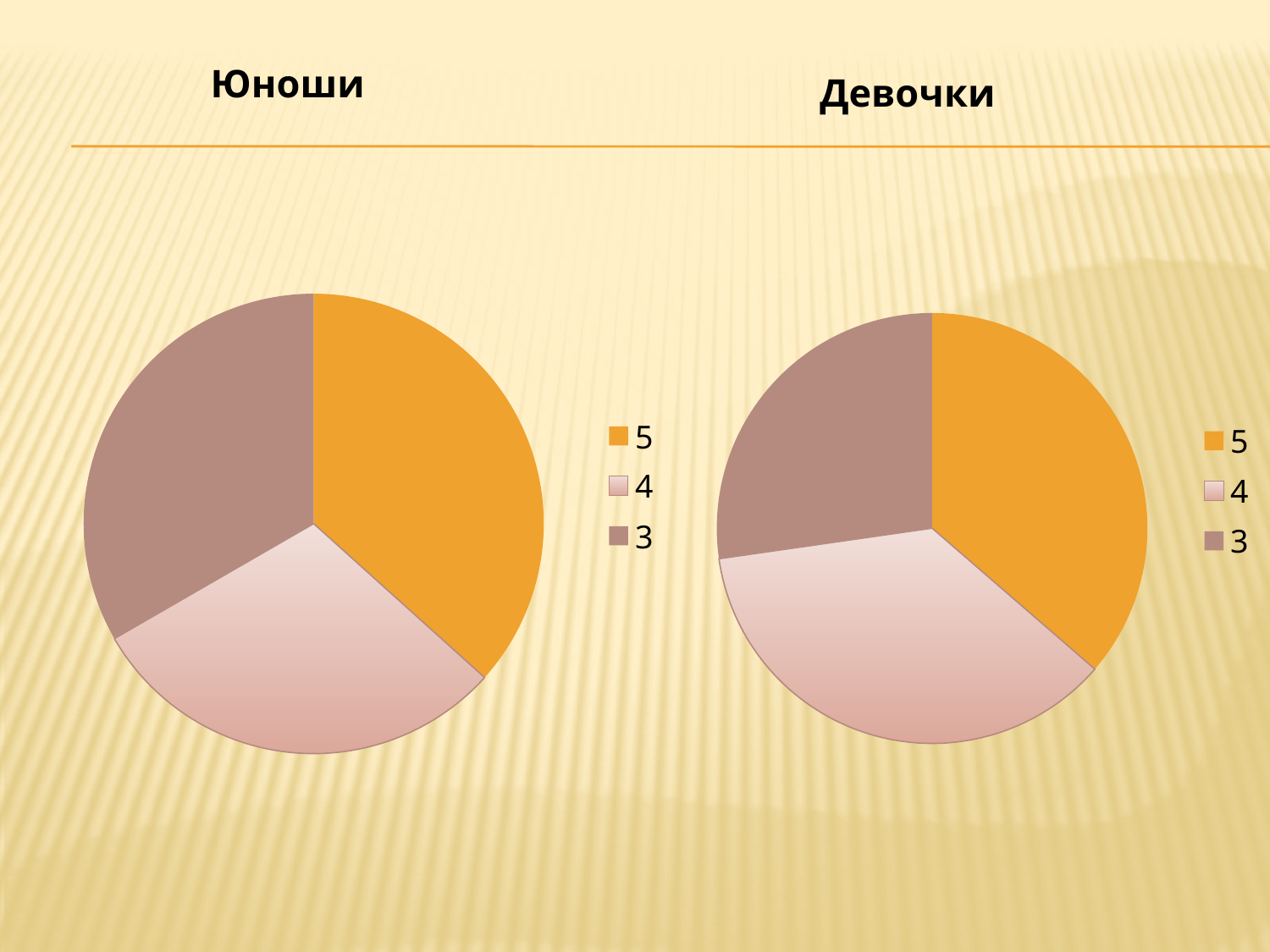
In the chart titled "Юноши", how many entries does the legend list? 3 In the chart titled "Девочки", which category has the smallest slice? 3 In the chart titled "Девочки", what colour is the slice for category 5? orange In the chart titled "Юноши", what are the legend entries? 5, 4, 3 In the chart titled "Девочки", how many slices does the pie have? 3 What kind of chart is the chart titled "Девочки"? pie chart In the chart titled "Юноши", how many slices does the pie have? 3 In the chart titled "Девочки", how many entries does the legend list? 3 In the chart titled "Девочки", is the slice for 5 larger or smaller than the slice for 3? larger What kind of chart is the chart titled "Юноши"? pie chart